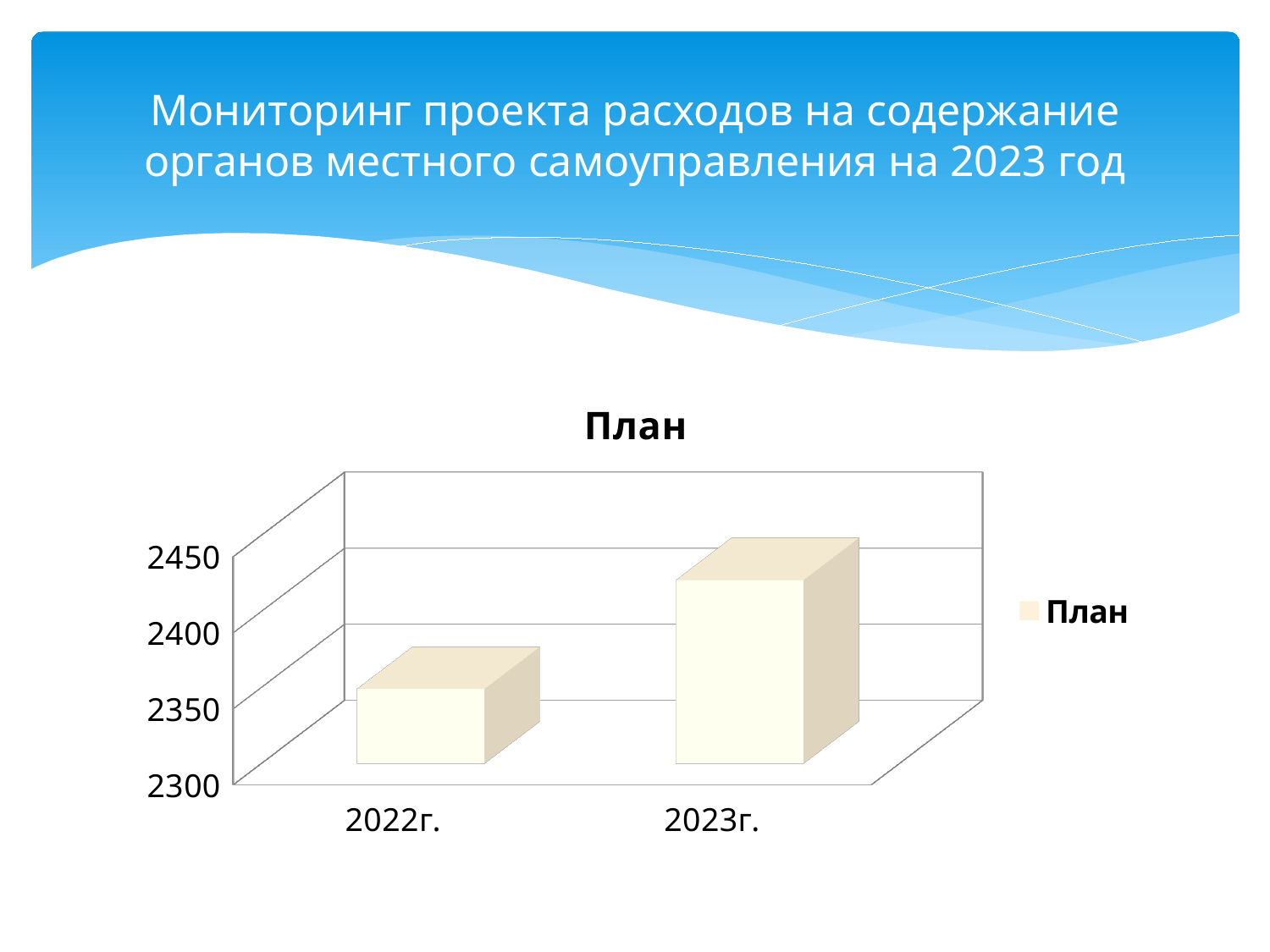
Which year has the highest value in the chart? 2023г. How many series does the chart legend list? 1 What is the title of the chart? План Which is larger, the value for 2022г. or the value for 2023г.? 2023г. How many categories are shown on the x axis of the chart? 2 Is the value for 2022г. greater or less than 2400? less Is the value for 2023г. greater or less than 2400? greater Which year has the lowest value in the chart? 2022г. What kind of chart is shown on the slide? bar chart What is the name of the series listed in the chart legend? План Do the values rise or fall from 2022г. to 2023г.? rise